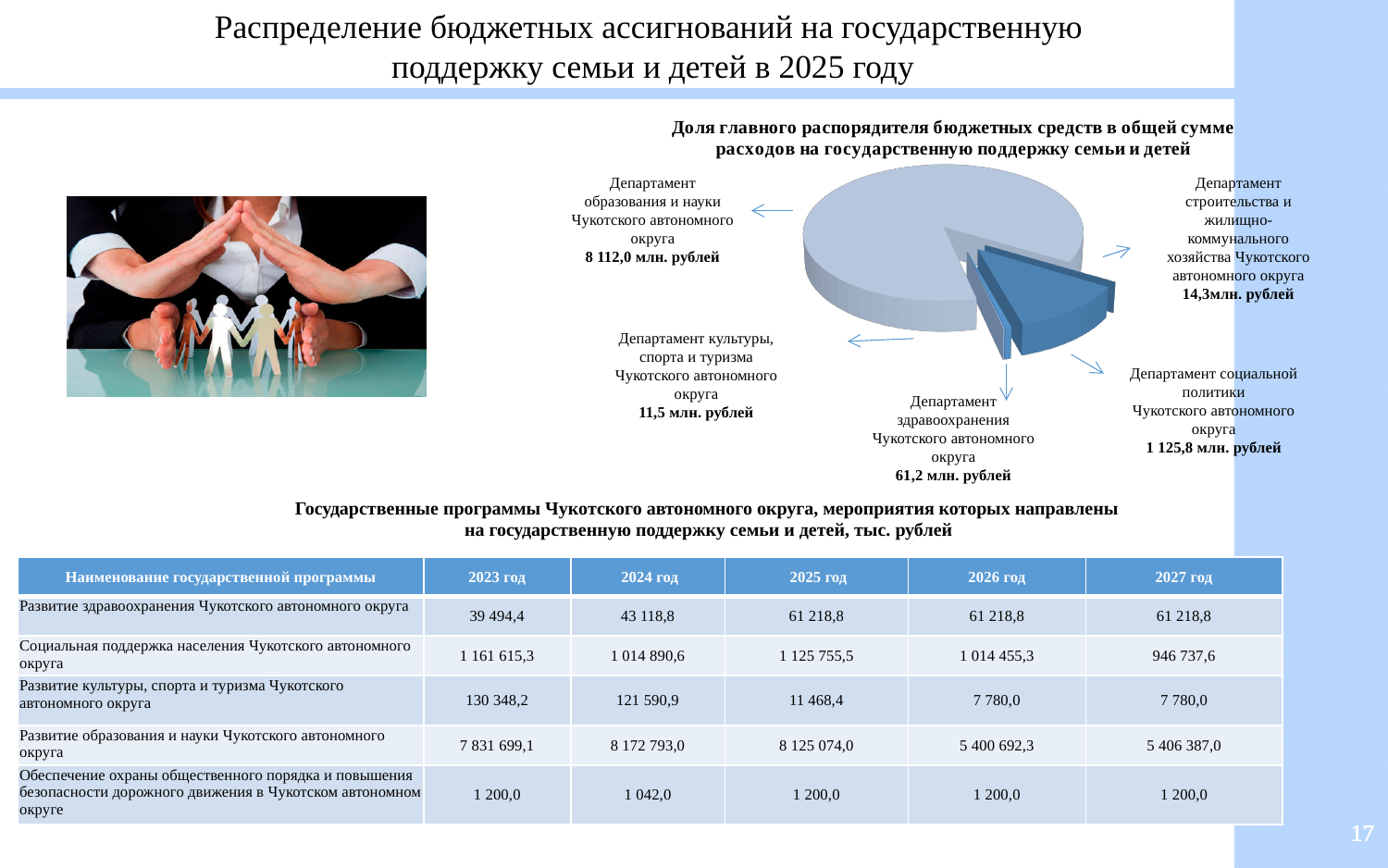
What is the value shown for Департамент здравоохранения Чукотского автономного округа in the pie chart? 61,2 млн. рублей Which is larger in the pie chart: the value for Департамент здравоохранения or for Департамент строительства и жилищно-коммунального хозяйства? Департамент здравоохранения What is the value shown for Департамент социальной политики Чукотского автономного округа in the pie chart? 1 125,8 млн. рублей What is the value shown for Департамент образования и науки Чукотского автономного округа in the pie chart? 8 112,0 млн. рублей What is the value shown for Департамент строительства и жилищно-коммунального хозяйства Чукотского автономного округа in the pie chart? 14,3 млн. рублей How many slices (departments) does the pie chart have? 5 By how much does the value for Департамент социальной политики exceed the value for Департамент здравоохранения in the pie chart? 1 064,6 млн. рублей What is the title of the pie chart? Доля главного распорядителя бюджетных средств в общей сумме расходов на государственную поддержку семьи и детей Which department has the largest value in the pie chart? Департамент образования и науки Чукотского автономного округа What kind of chart is shown on the slide? Pie chart What is the value shown for Департамент культуры, спорта и туризма Чукотского автономного округа in the pie chart? 11,5 млн. рублей Which department has the smallest value in the pie chart? Департамент культуры, спорта и туризма Чукотского автономного округа